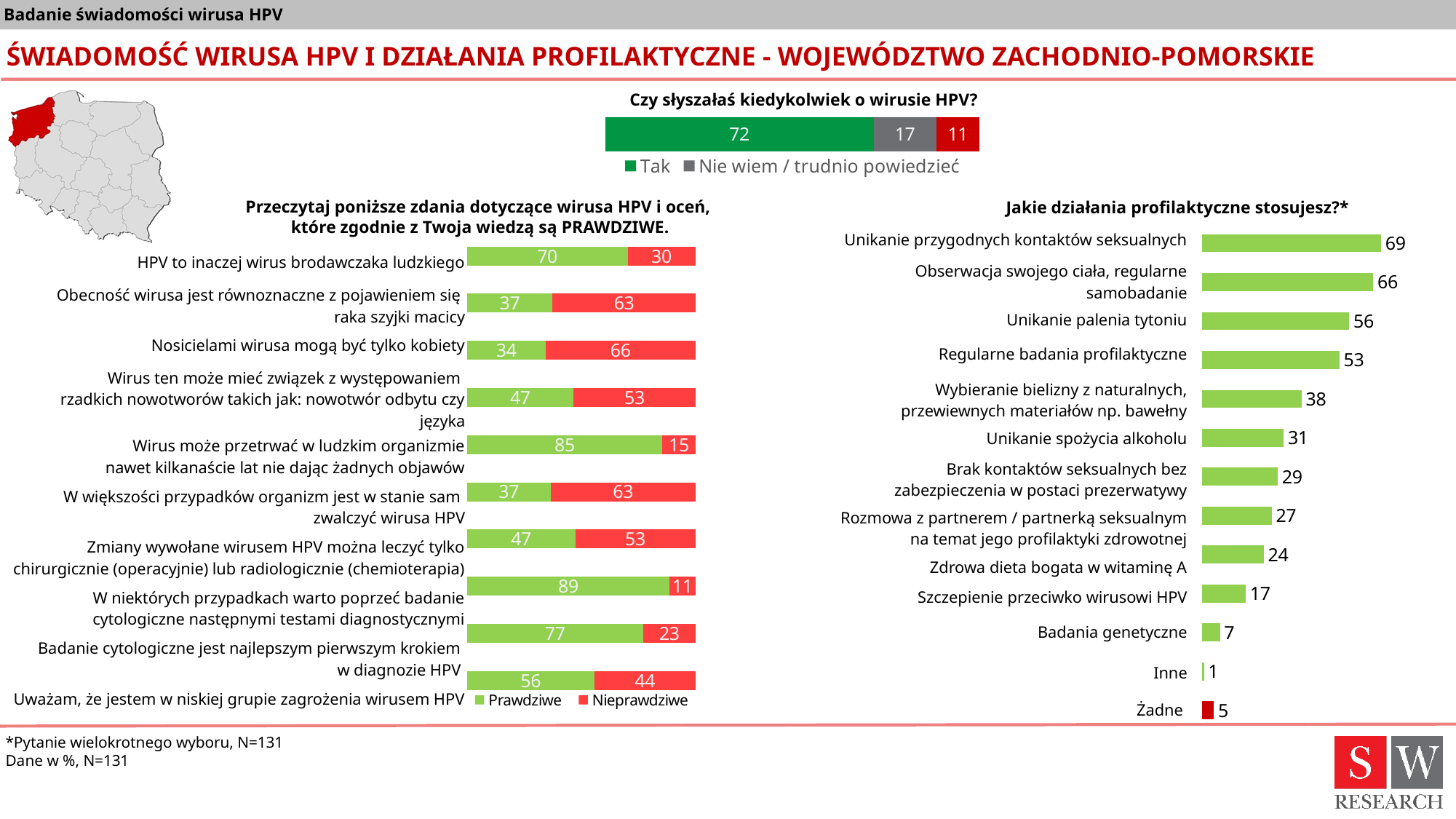
In the chart 'Jakie działania profilaktyczne stosujesz?', what is the difference between 'Regularne badania profilaktyczne' and 'Szczepienie przeciwko wirusowi HPV'? 36 In the chart 'Czy słyszałaś kiedykolwiek o wirusie HPV?', what is the value for 'Tak'? 72 In the chart 'Przeczytaj poniższe zdania dotyczące wirusa HPV...', how many series does the legend list? 2 In the chart 'Jakie działania profilaktyczne stosujesz?', how many categories are shown? 13 In the chart 'Jakie działania profilaktyczne stosujesz?', what kind of chart is it? Bar chart In the chart 'Przeczytaj poniższe zdania dotyczące wirusa HPV...', what is the 'Prawdziwe' value for 'Wirus może przetrwać w ludzkim organizmie nawet kilkanaście lat nie dając żadnych objawów'? 85 In the chart 'Przeczytaj poniższe zdania dotyczące wirusa HPV...', what is the 'Nieprawdziwe' value for 'Nosicielami wirusa mogą być tylko kobiety'? 66 In the chart 'Jakie działania profilaktyczne stosujesz?', which category has the lowest value? Inne In the chart 'Jakie działania profilaktyczne stosujesz?', which category has the highest value? Unikanie przygodnych kontaktów seksualnych In the chart 'Czy słyszałaś kiedykolwiek o wirusie HPV?', what is the value for 'Nie wiem / trudno powiedzieć'? 17 In the chart 'Jakie działania profilaktyczne stosujesz?', what is the value for 'Unikanie palenia tytoniu'? 56 In the chart 'Przeczytaj poniższe zdania dotyczące wirusa HPV...', which is larger: the 'Prawdziwe' value for 'HPV to inaczej wirus brodawczaka ludzkiego' or for 'Uważam, że jestem w niskiej grupie zagrożenia wirusem HPV'? HPV to inaczej wirus brodawczaka ludzkiego